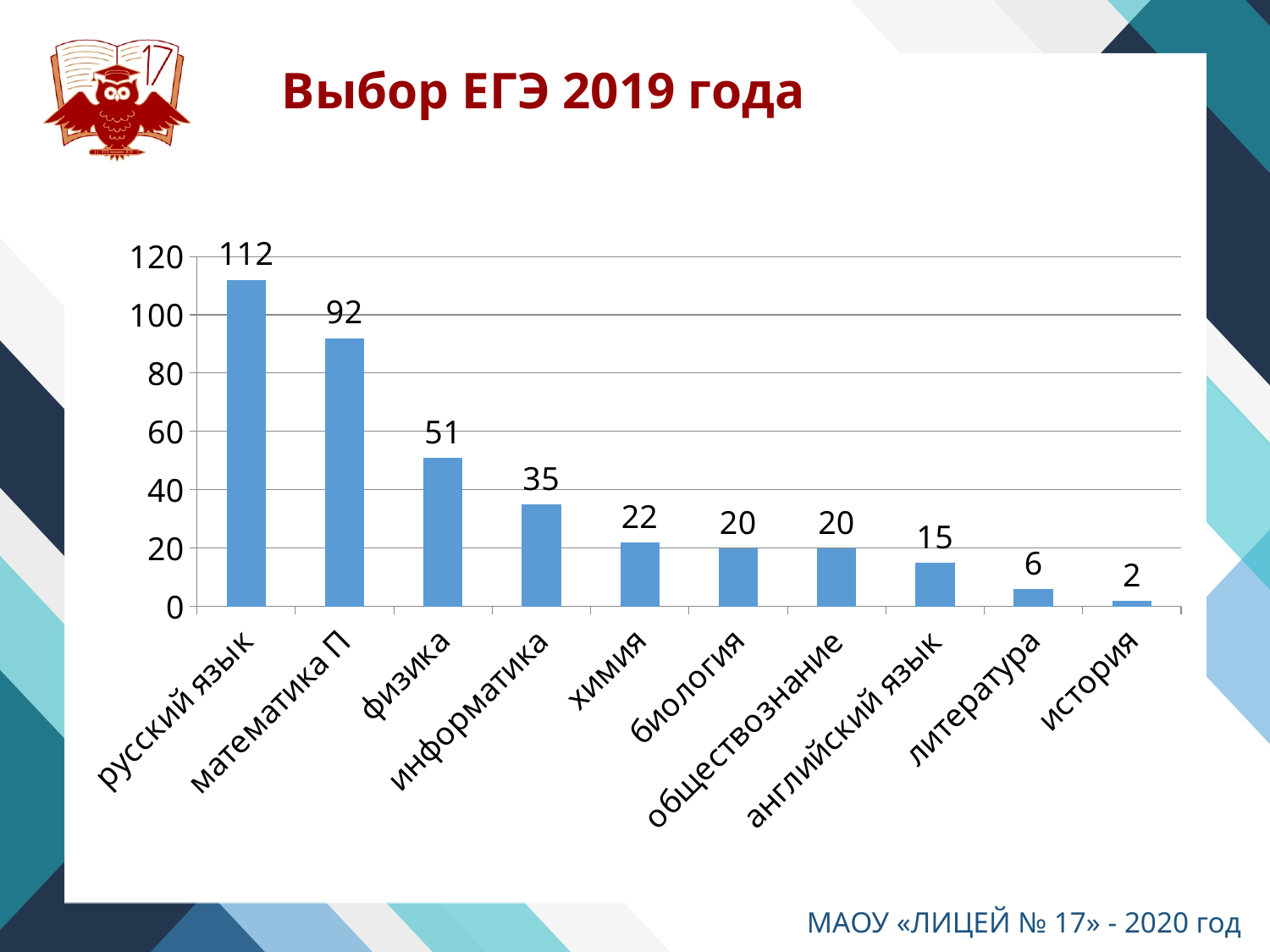
What is the value for информатика? 35 What is the value for физика? 51 What is the value for английский язык? 15 Which category has the highest value? русский язык What is the difference between the values for химия and литература? 16 Which category has the lowest value? история Which is larger, the value for физика or the value for информатика? физика What kind of chart is shown on the slide? bar chart What is the difference between the values for русский язык and математика П? 20 Do the values rise or fall from left to right along the x axis? fall What is the title of the slide? Выбор ЕГЭ 2019 года How many categories are shown on the x axis? 10